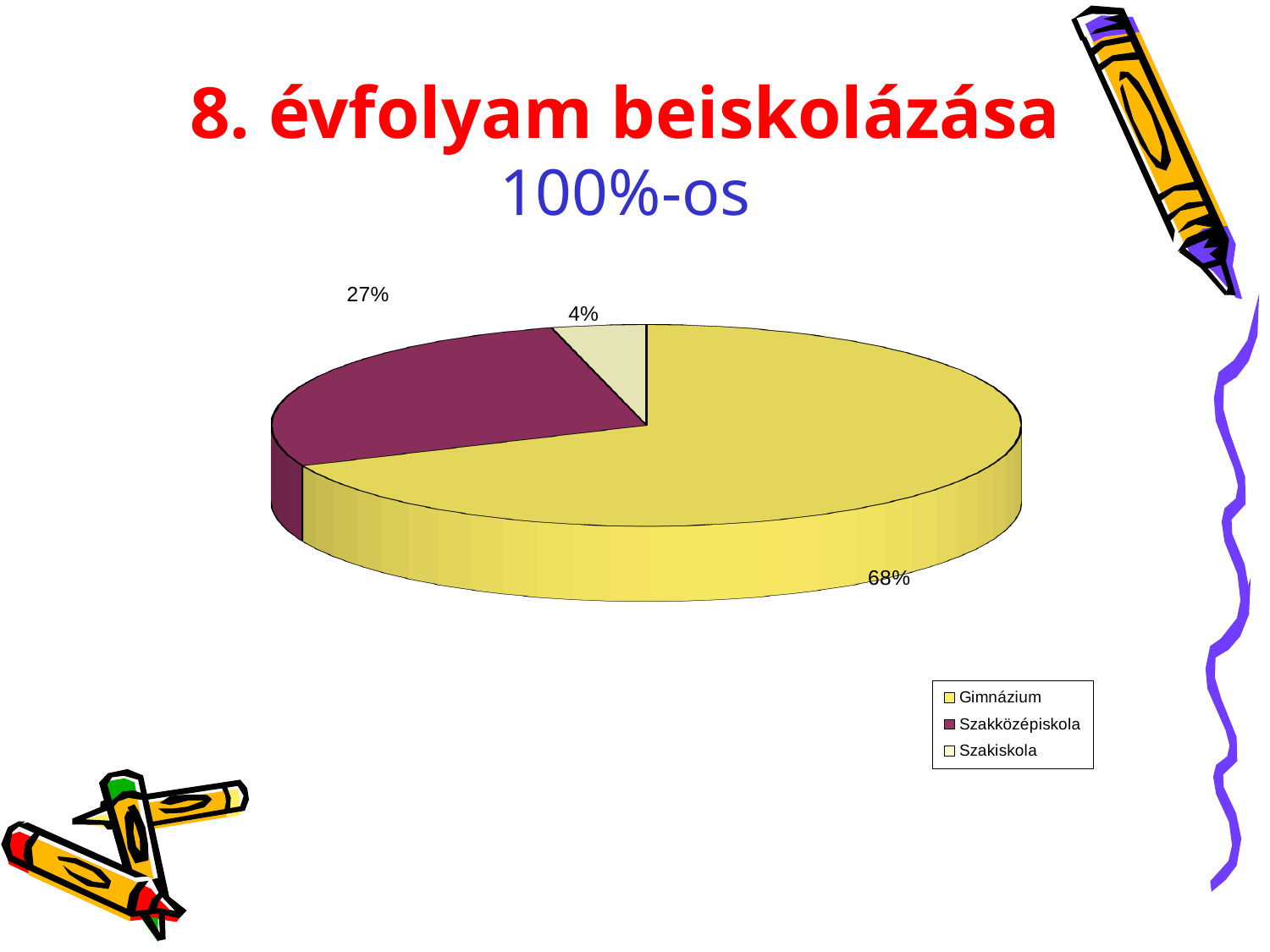
What colour is the Szakközépiskola slice in the pie chart? purple What is the difference in percentage points between Szakközépiskola and Szakiskola? 23 What share of the pie does Gimnázium have? 68% What share of the pie does Szakközépiskola have? 27% What is the difference in percentage points between Gimnázium and Szakközépiskola? 41 How many entries does the legend list? 3 Which category has the smallest slice of the pie? Szakiskola What kind of chart is shown on the slide? pie chart Which is larger, the share for Szakközépiskola or the share for Szakiskola? Szakközépiskola How many categories does the pie chart show? 3 What share of the pie does Szakiskola have? 4% Which category has the largest slice of the pie? Gimnázium